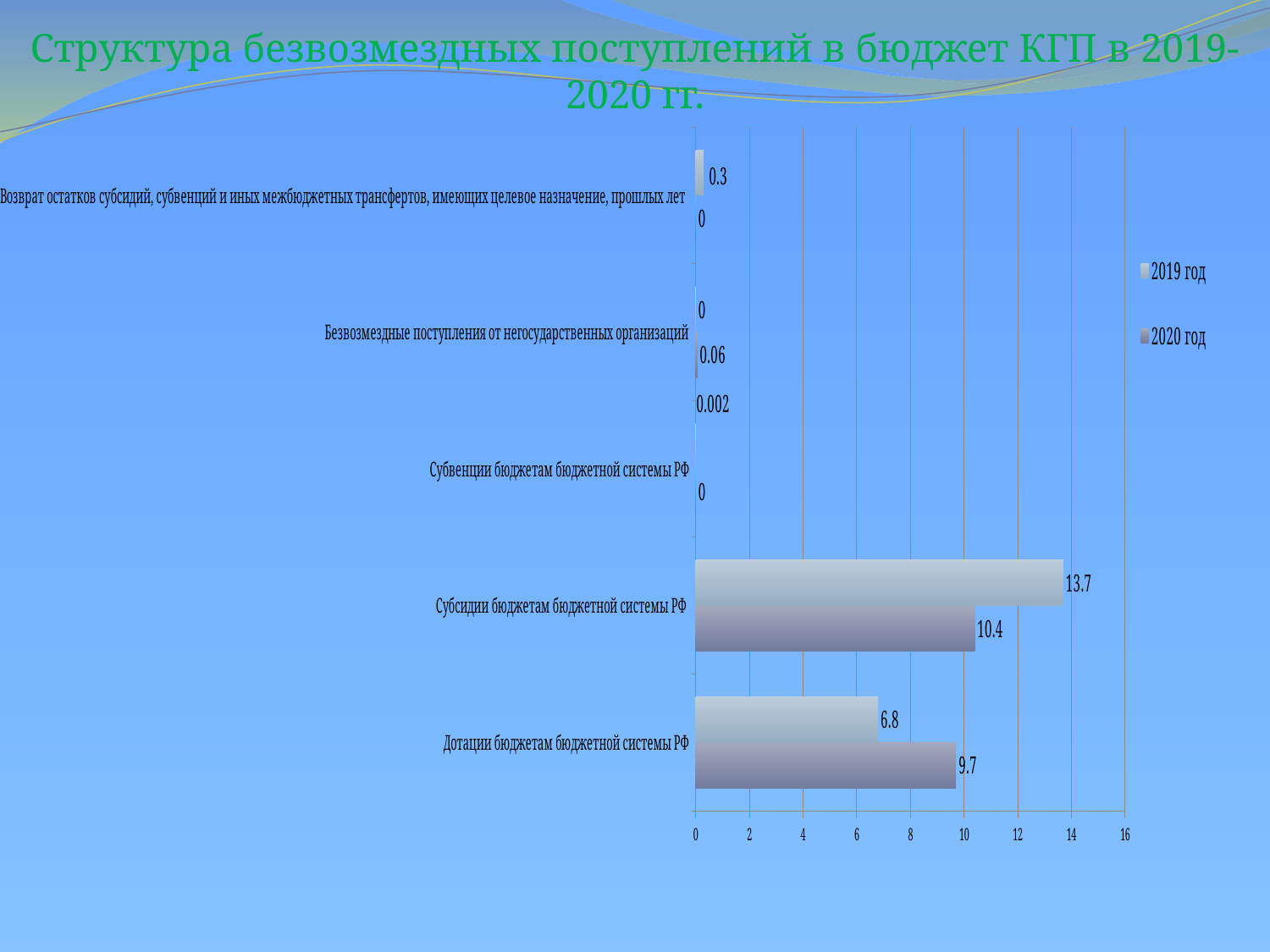
How many series does the legend list? 2 Which category has the highest value in the 2019 год series? Субсидии бюджетам бюджетной системы РФ What is the value for Субсидии бюджетам бюджетной системы РФ in 2020 год? 10.4 What is the difference between the 2020 год and 2019 год values for Дотации бюджетам бюджетной системы РФ? 2.9 What is the value for Дотации бюджетам бюджетной системы РФ in 2020 год? 9.7 How many categories are shown on the chart? 5 What type of chart is shown on the slide? bar chart What is the difference between the 2019 год and 2020 год values for Субсидии бюджетам бюджетной системы РФ? 3.3 What is the value for Субсидии бюджетам бюджетной системы РФ in 2019 год? 13.7 What is the value for Безвозмездные поступления от негосударственных организаций in 2020 год? 0.06 What is the title of the chart on the slide? Структура безвозмездных поступлений в бюджет КГП в 2019-2020 гг. For Дотации бюджетам бюджетной системы РФ, which year has the larger value, 2019 год or 2020 год? 2020 год